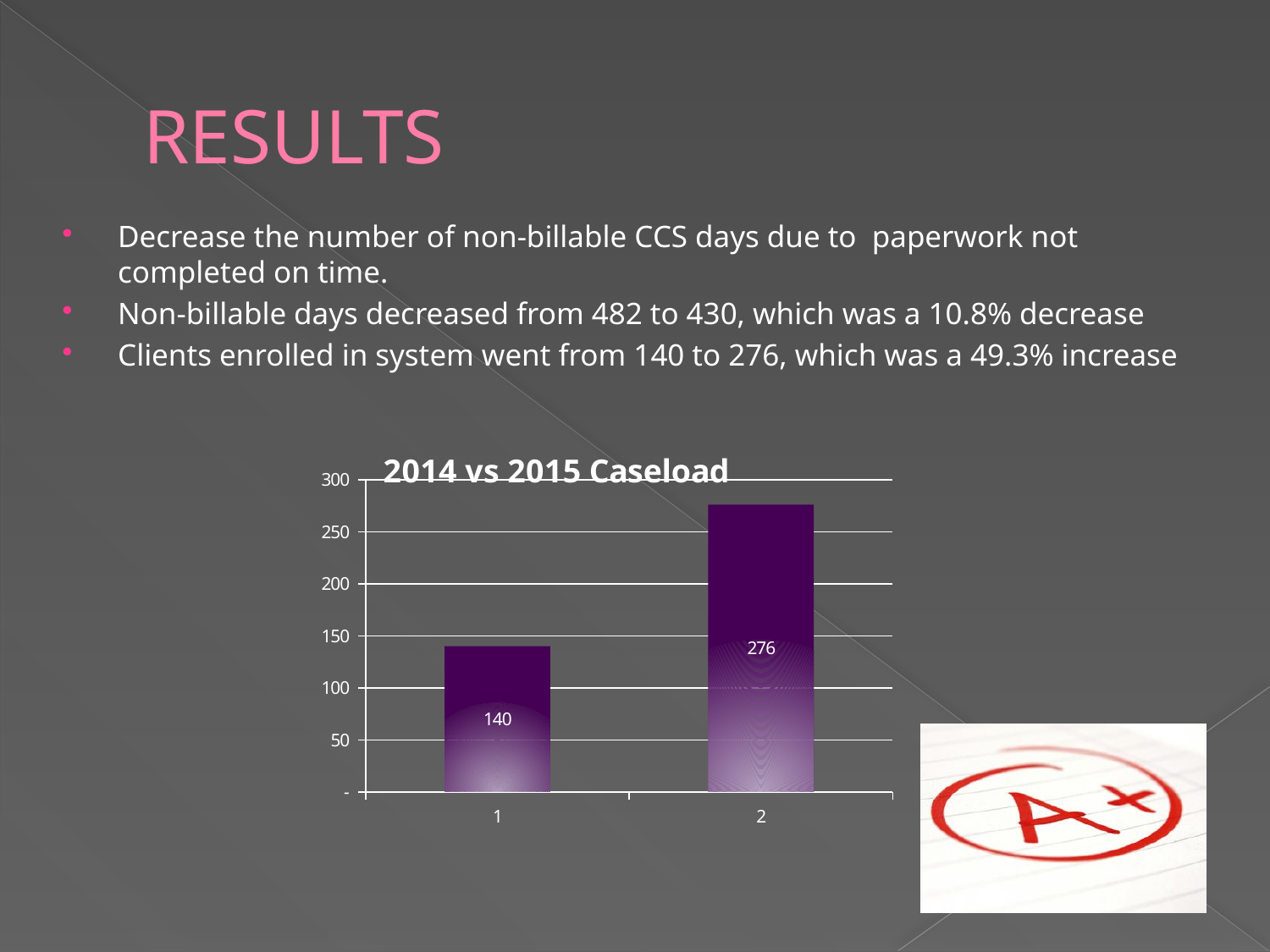
How many bars are plotted in the chart? 2 Which category has the lowest value in the chart? 1 Is the value for category 1 greater or less than 150? less Which is larger, the value for category 1 or category 2? 2 What is the difference between the values for category 2 and category 1? 136 What is the title of the chart? 2014 vs 2015 Caseload Do the values rise or fall from category 1 to category 2? rise What is the value for category 2 in the 2014 vs 2015 Caseload chart? 276 What kind of chart is shown on the slide? bar chart Is the value for category 2 greater or less than 250? greater What is the value for category 1 in the 2014 vs 2015 Caseload chart? 140 Which category has the highest value in the chart? 2